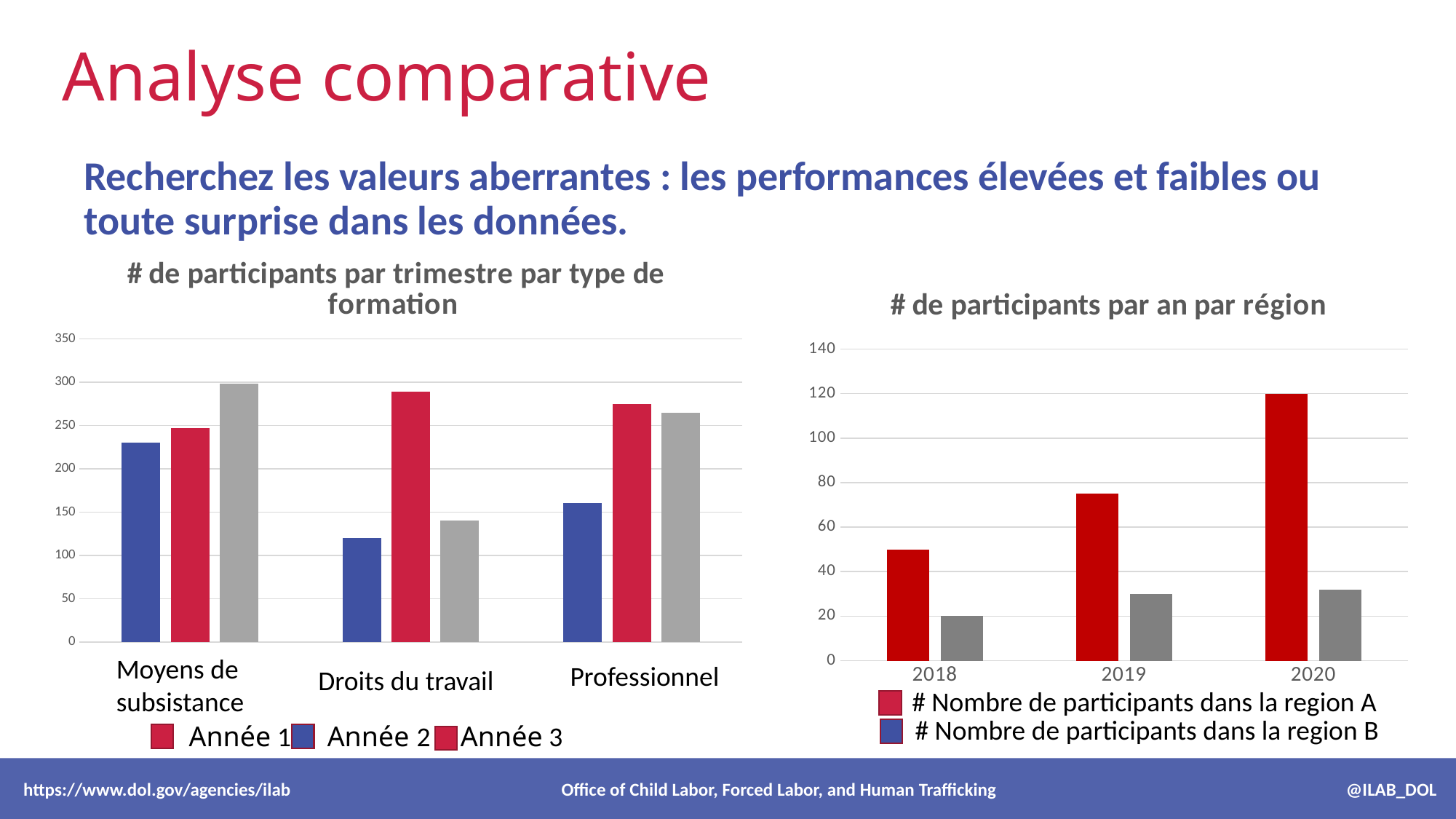
On the chart '# de participants par an par région', in which year is the value for region A highest? 2020 How many categories are shown on the x axis of the chart '# de participants par trimestre par type de formation'? 3 On the chart '# de participants par an par région', which is larger in 2019: region A or region B? region A On the chart '# de participants par trimestre par type de formation', which category contains the lowest single bar? Droits du travail On the chart '# de participants par an par région', what is the value for region B in 2018? 20 On the chart '# de participants par an par région', what is the value for region A in 2020? 120 What kind of chart is '# de participants par trimestre par type de formation'? bar chart How many series does the legend of the chart '# de participants par trimestre par type de formation' list? 3 How many series does the legend of the chart '# de participants par an par région' list? 2 On the chart '# de participants par an par région', do the values for region A rise or fall from 2018 to 2020? rise On the chart '# de participants par an par région', what is the difference between region A in 2020 and region B in 2018? 100 On the chart '# de participants par an par région', is the value for region A in 2019 greater or less than 60? greater